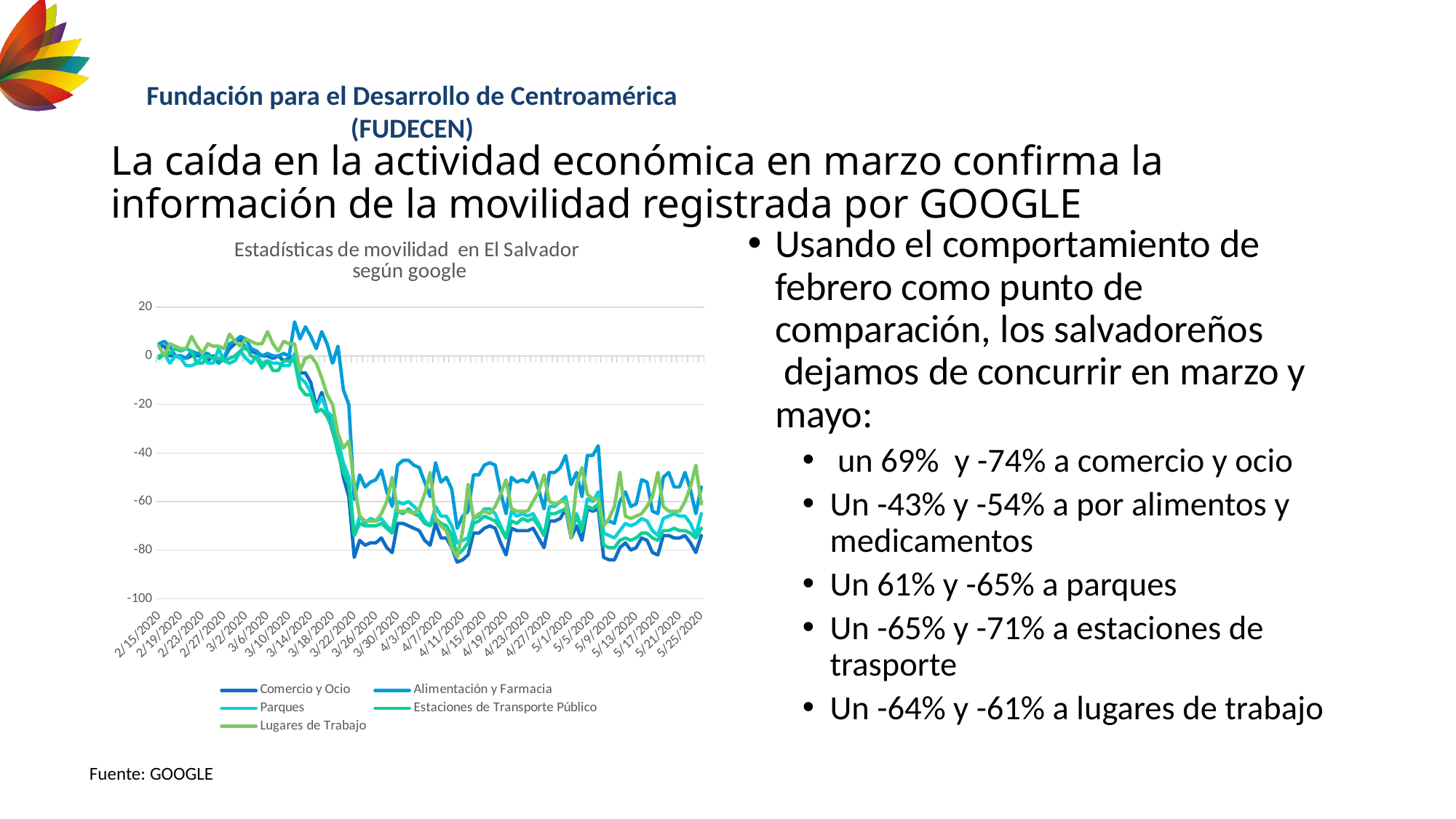
What is the last date shown on the x axis of the chart? 5/25/2020 What is the title of the chart? Estadísticas de movilidad en El Salvador según google What kind of chart is shown on the slide? line chart How many series does the legend of the chart list? 5 What is the first date shown on the x axis of the chart? 2/15/2020 Which series are listed in the chart's legend? Comercio y Ocio, Alimentación y Farmacia, Parques, Estaciones de Transporte Público, Lugares de Trabajo Which series has the highest values during April 2020? Alimentación y Farmacia Is the value for Alimentación y Farmacia on 3/14/2020 greater or less than 0? greater Do the values of the series rise or fall between early March and late March 2020? fall Which series has the lowest values during April 2020? Comercio y Ocio Is the value for Comercio y Ocio on 2/15/2020 greater or less than -20? greater Is the value for Comercio y Ocio on 3/26/2020 greater or less than -60? less